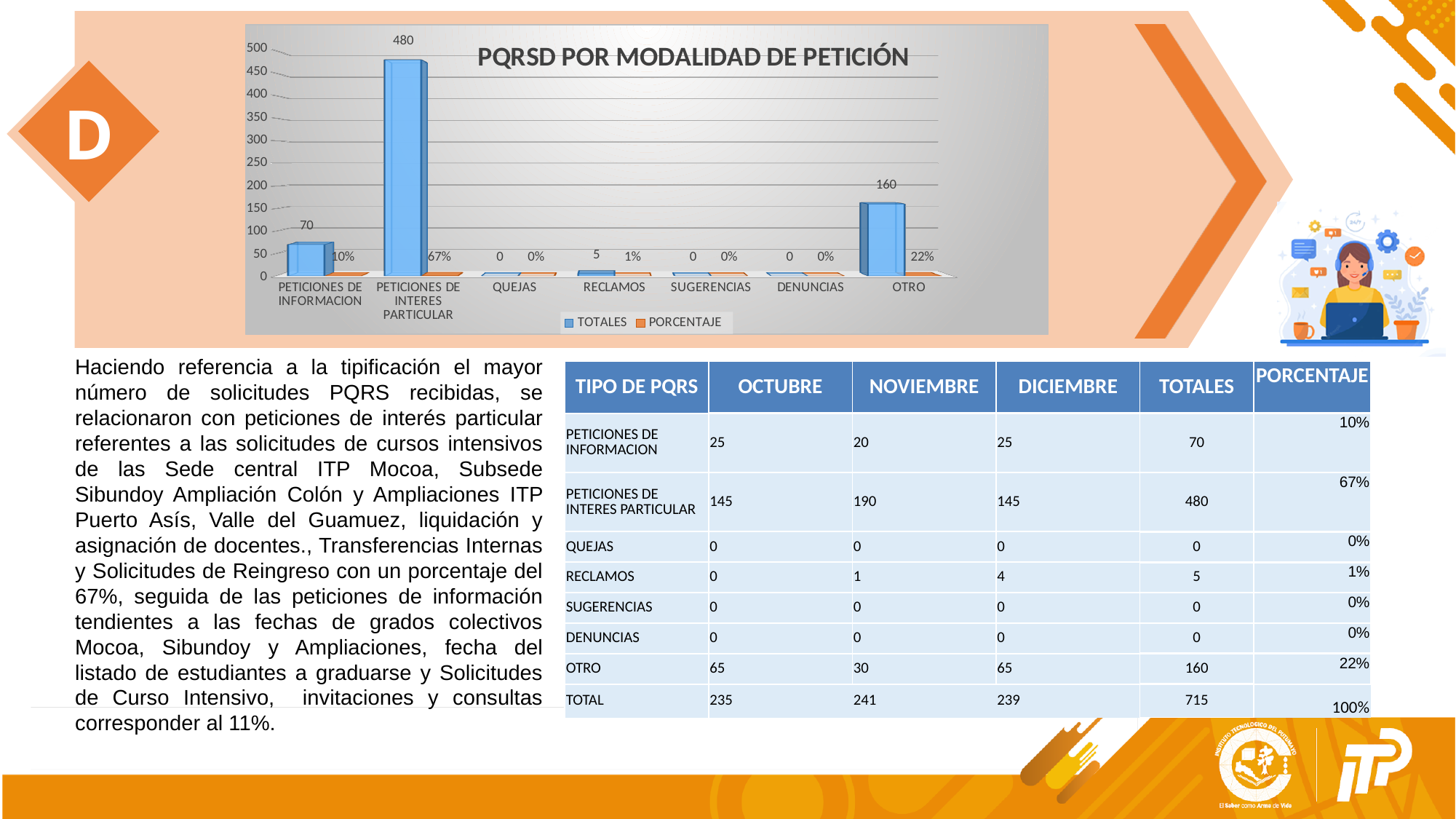
Which category has the highest TOTALES value in the chart? PETICIONES DE INTERES PARTICULAR What PORCENTAJE is shown for PETICIONES DE INFORMACION in the chart? 10% How many categories are shown on the x axis of the chart? 7 What kind of chart is shown on the slide? Bar chart What is the TOTALES value for OTRO in the chart? 160 What PORCENTAJE is shown for OTRO in the chart? 22% Which has a larger TOTALES value, PETICIONES DE INFORMACION or OTRO? OTRO What is the difference between the TOTALES values for PETICIONES DE INTERES PARTICULAR and OTRO? 320 What is the TOTALES value for PETICIONES DE INTERES PARTICULAR in the chart? 480 How many series does the chart legend list? 2 What is the title of the chart? PQRSD POR MODALIDAD DE PETICIÓN What is the TOTALES value for RECLAMOS in the chart? 5